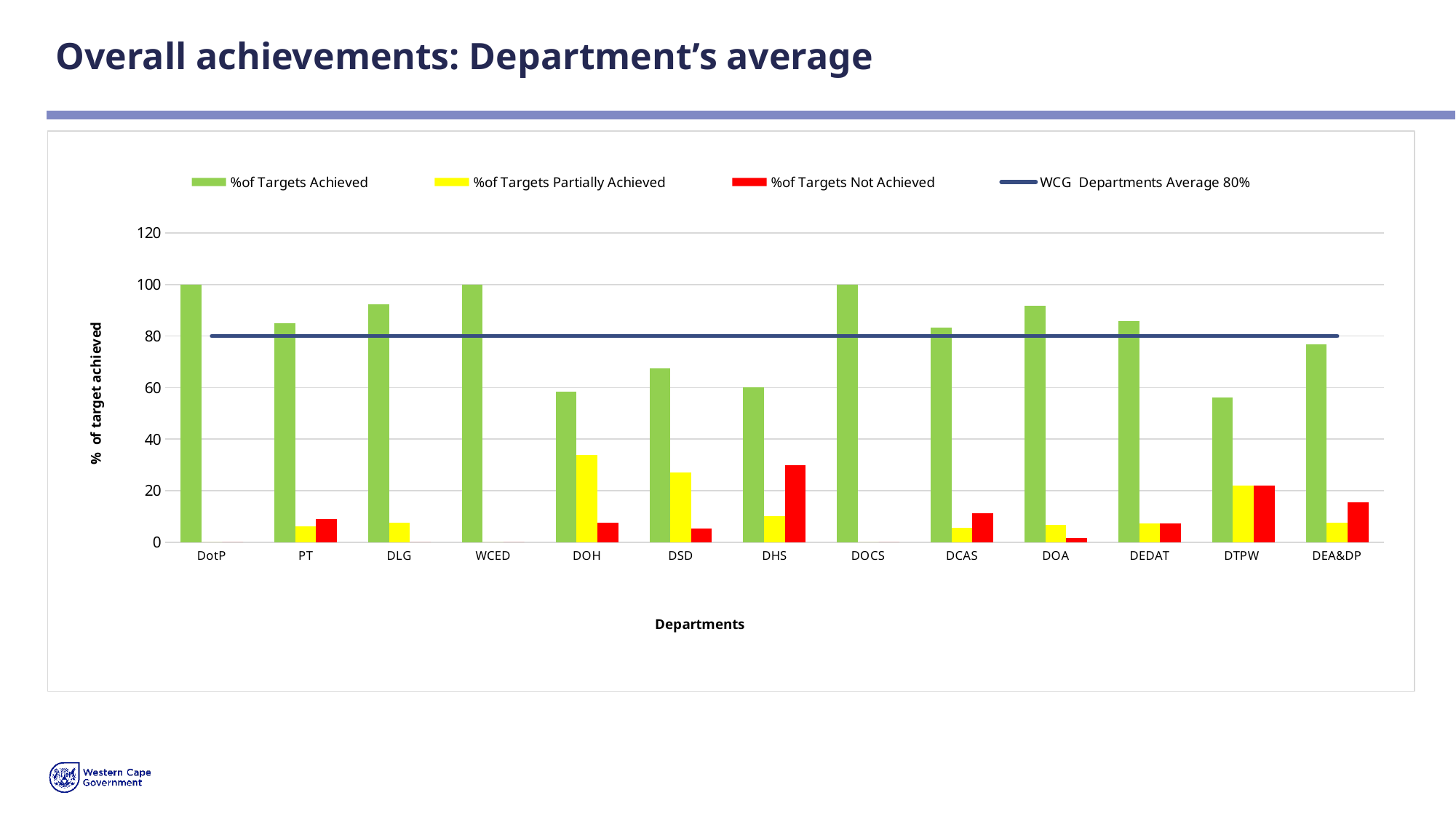
Which departments have a % of Targets Achieved of 100? DotP, WCED, DOCS Which department has the highest % of Targets Not Achieved? DHS What is the % of Targets Achieved for WCED? 100 Is the % of Targets Achieved for DEA&DP greater or less than 80? less How many series does the legend list? 4 How many departments are shown on the x axis? 13 What is the % of Targets Achieved for DotP? 100 Which is larger, the % of Targets Achieved for DSD or for DOH? DSD What value does the WCG Departments Average line represent? 80% Which department has the highest % of Targets Partially Achieved? DOH Is the % of Targets Achieved for DTPW greater or less than 60? less What kind of chart is shown on the slide? combination bar and line chart